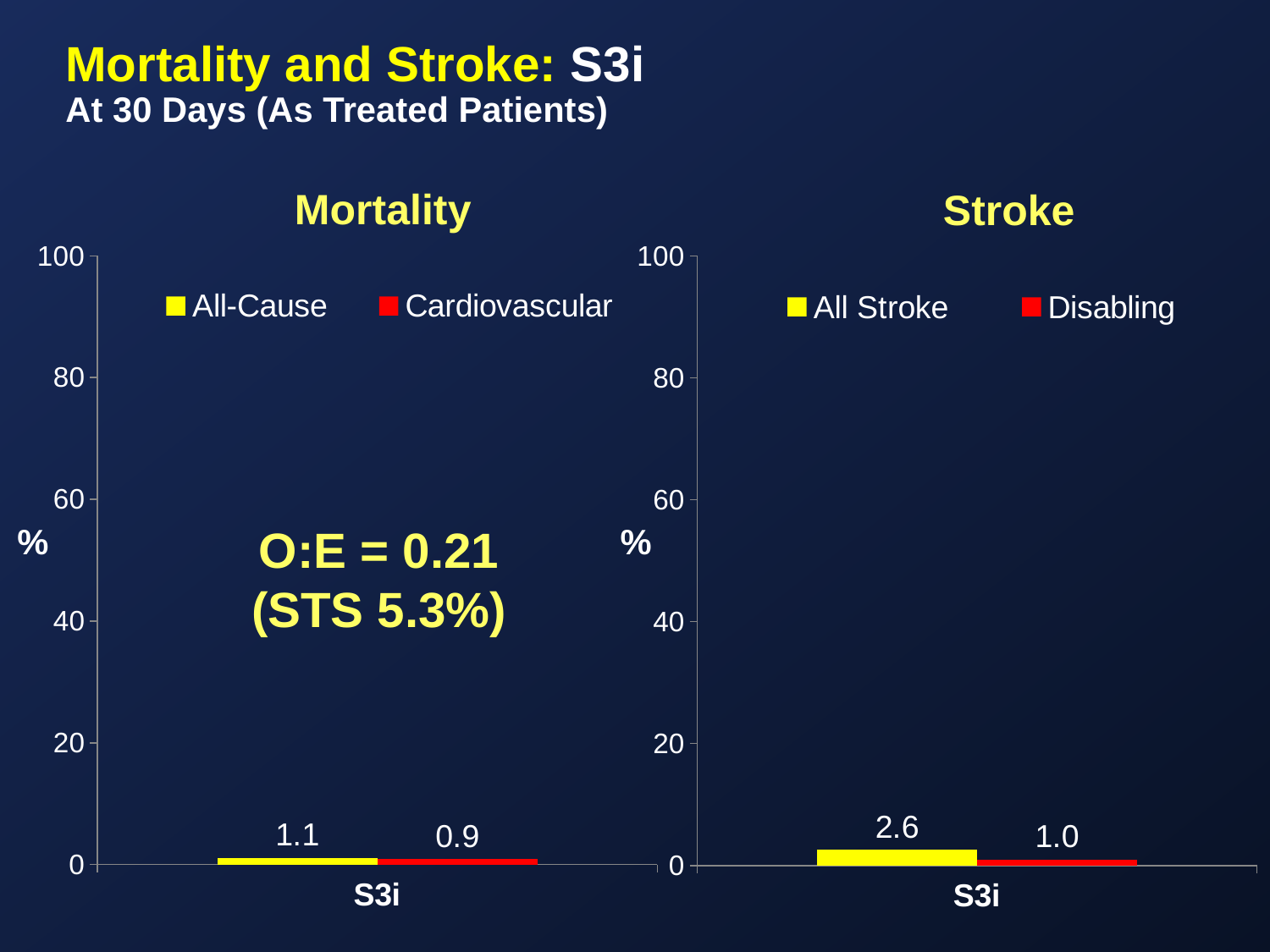
In the Mortality chart, what colour represents the Cardiovascular series? red In the Stroke chart, which is larger, All Stroke or Disabling? All Stroke In the Stroke chart, what is the difference between the All Stroke and Disabling values? 1.6 How many series does the legend of the Stroke chart list? 2 What kind of chart is the Mortality chart? bar chart In the Stroke chart, what is the Disabling value for S3i? 1.0 In the Mortality chart, what is the difference between the All-Cause and Cardiovascular values? 0.2 In the Mortality chart, what is the All-Cause value for S3i? 1.1 In the Mortality chart, what is the Cardiovascular value for S3i? 0.9 In the Mortality chart, is the All-Cause value greater or less than 20? less What is the title of the chart on the right side of the slide? Stroke In the Stroke chart, what is the All Stroke value for S3i? 2.6